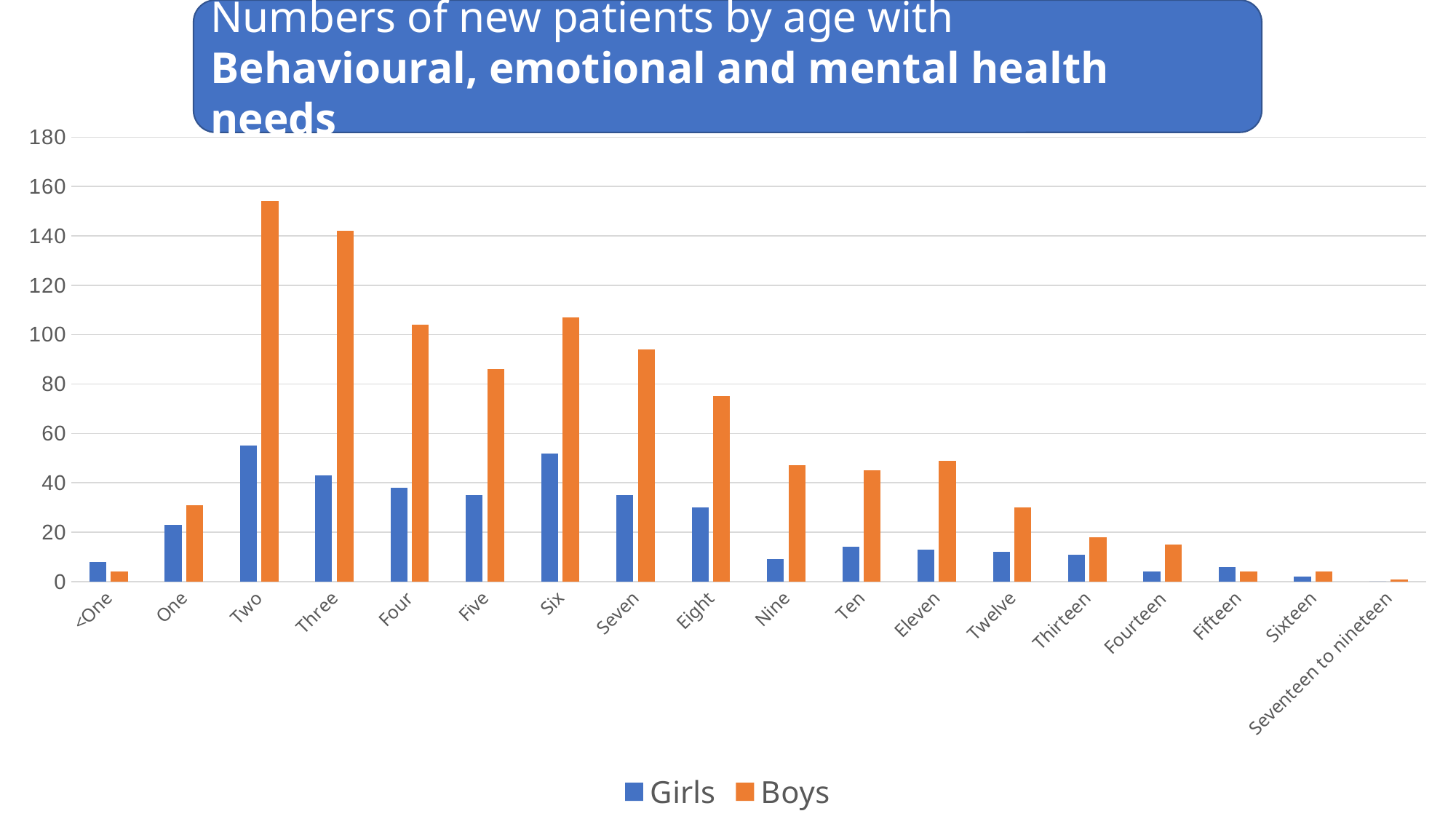
Which age category has the lowest value for Boys? Seventeen to nineteen At age Two, which is larger, the value for Girls or the value for Boys? Boys What are the two series named in the legend? Girls and Boys Is the value for Boys at age Two greater or less than 140? greater What kind of chart is shown on the slide? bar chart Is the value for Girls at age Ten greater or less than 20? less How many series does the legend list? 2 Which age category has the highest value for Boys? Two How many age categories are shown on the x axis? 18 Is the value for Girls at age Two greater or less than 40? greater For Boys, which is larger, the value at age Six or the value at age Seven? Six Which age category has the highest value for Girls? Two